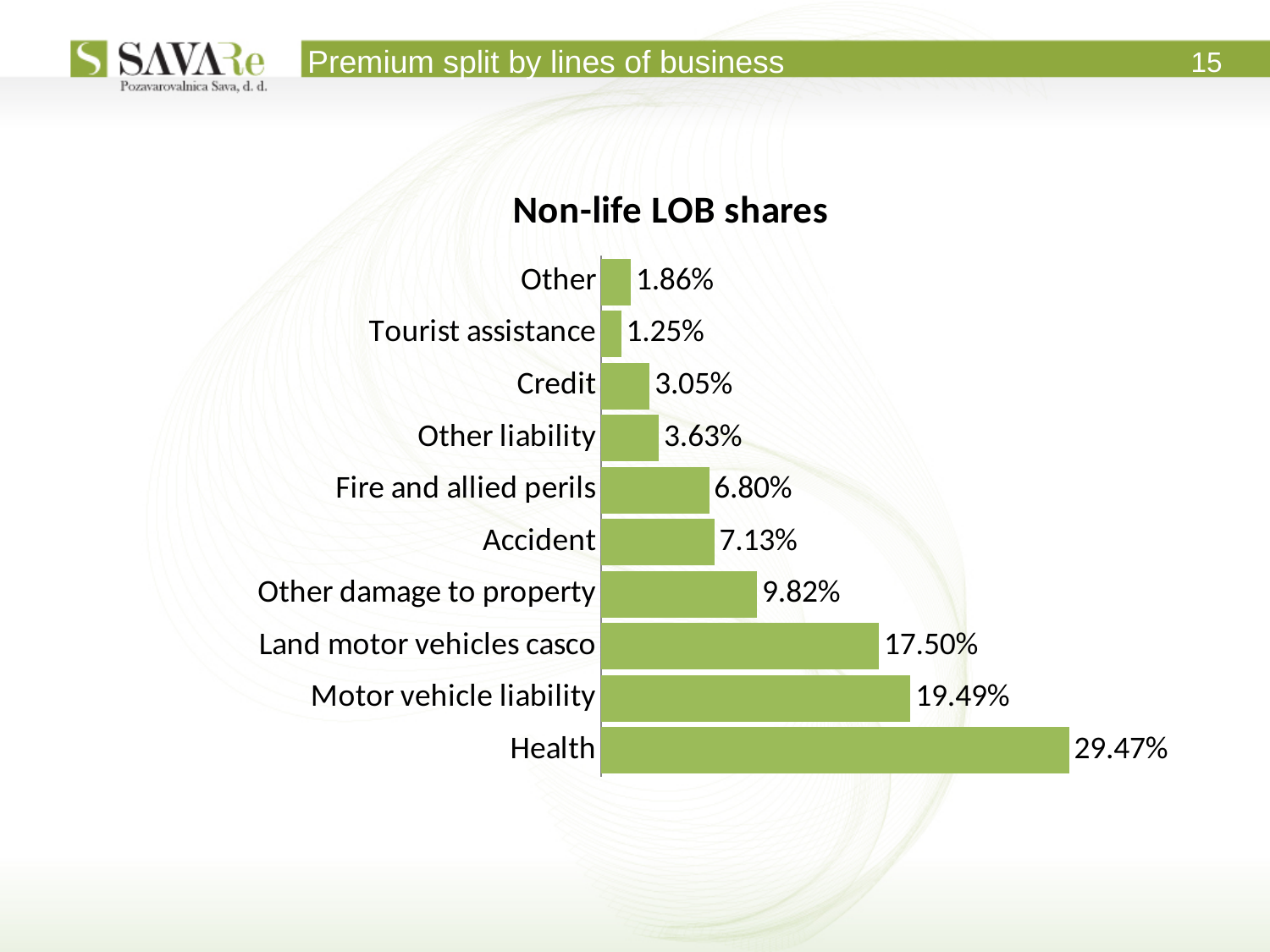
What is the share for Tourist assistance? 1.25% What kind of chart is shown on the slide? Bar chart What is the share for Health? 29.47% Which line of business has the lowest share? Tourist assistance What is the difference between the shares for Accident and Fire and allied perils? 0.33% Which has a larger share, Other damage to property or Accident? Other damage to property What is the share for Land motor vehicles casco? 17.50% What is the title of the chart? Non-life LOB shares Which line of business has the highest share? Health What is the difference between the shares for Health and Motor vehicle liability? 9.98% Which has a larger share, Credit or Other liability? Other liability How many lines of business are shown in the chart? 10